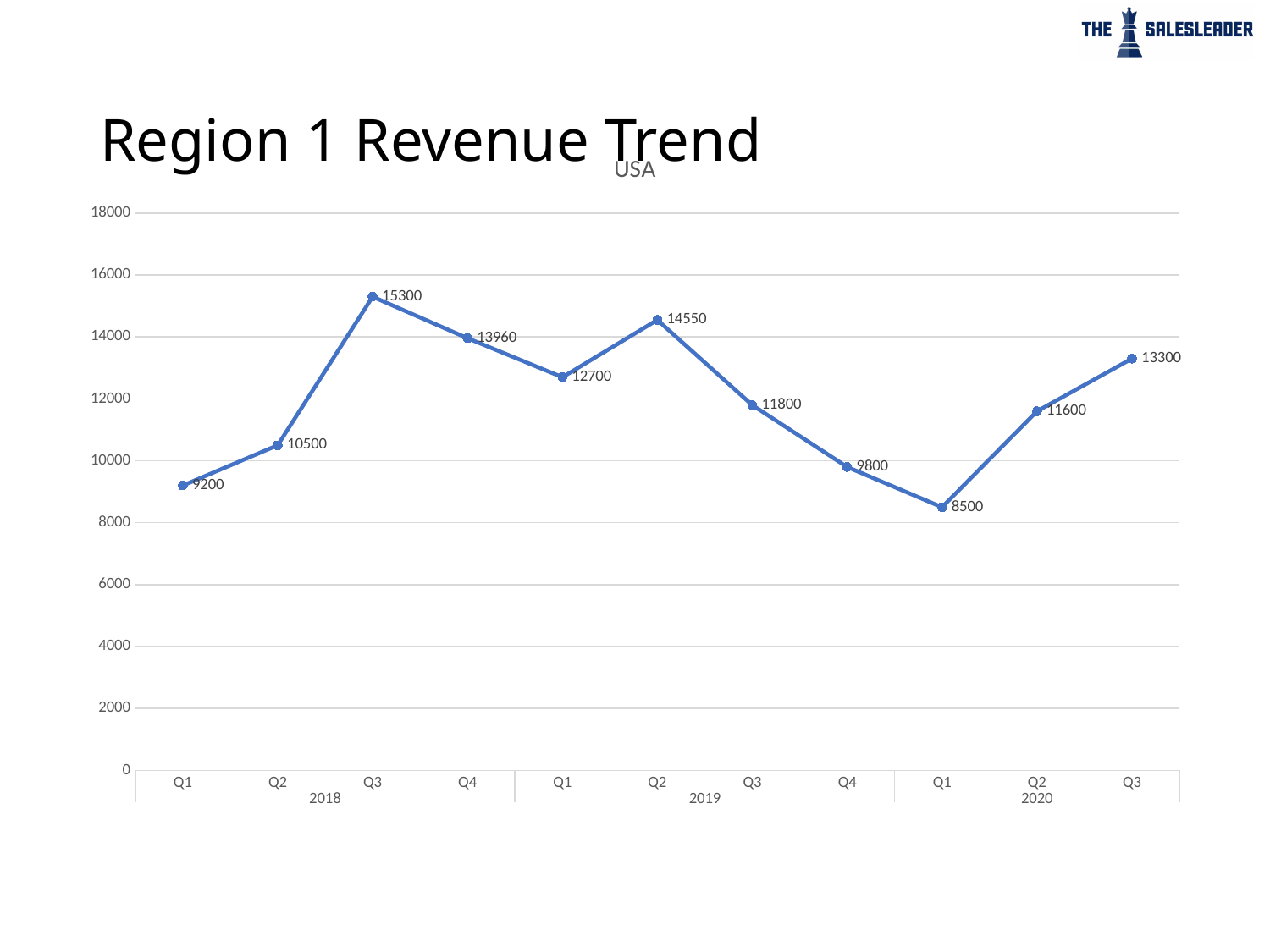
Which quarter has the lowest value? Q1 2020 How many data points are plotted on the chart? 11 Is the value for Q1 2019 greater or less than 12000? greater What is the value for Q1 2020? 8500 What kind of chart is shown on the slide? line chart Which quarter has the highest value? Q3 2018 What is the title shown above the chart's plot area? USA What is the value for Q3 2018? 15300 What is the value for Q4 2019? 9800 Which is larger, the value for Q4 2018 or the value for Q3 2020? Q4 2018 Do the values rise or fall from Q1 2020 to Q3 2020? rise What is the difference between the values for Q2 2019 and Q3 2019? 2750